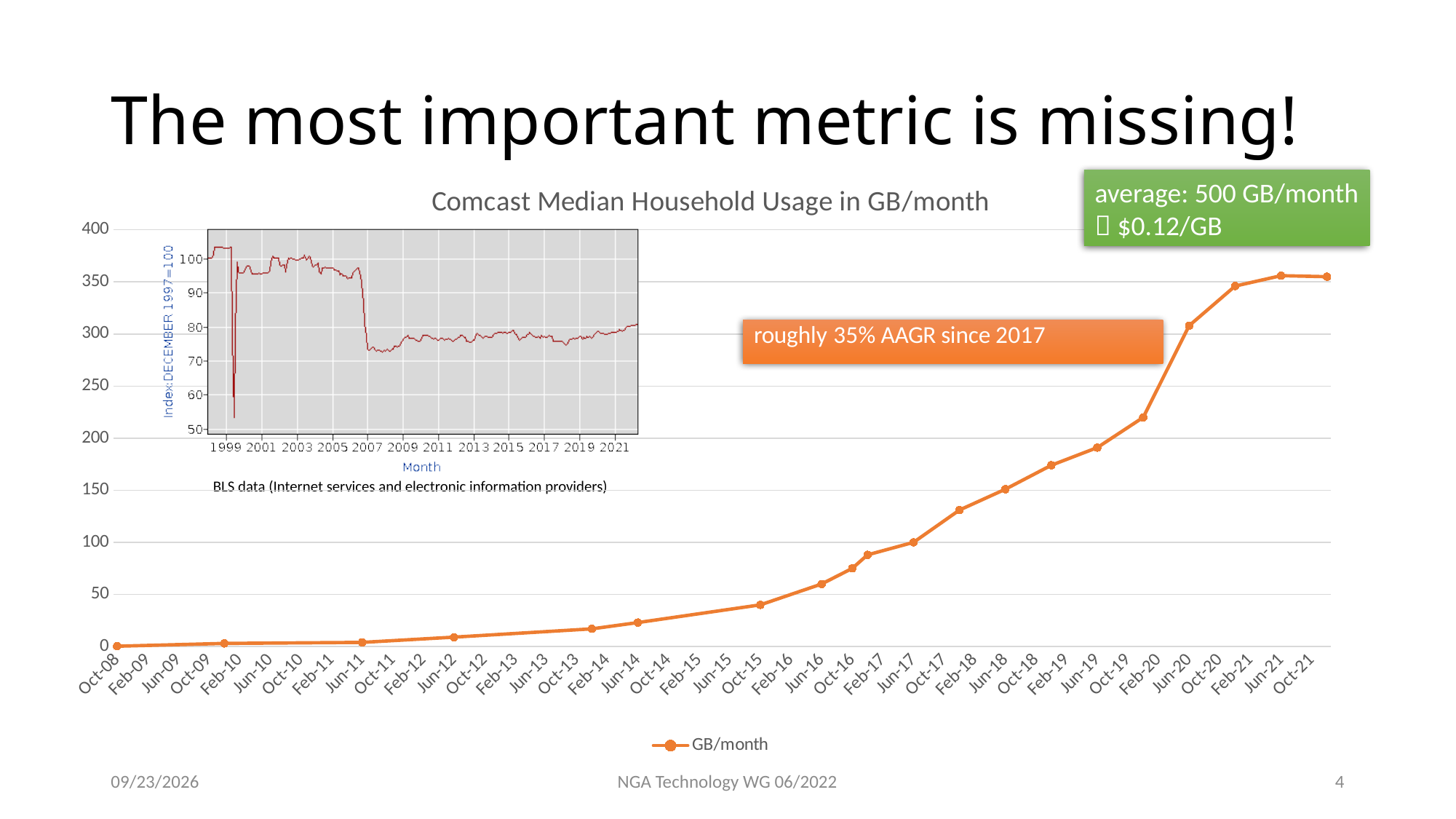
How many series does the legend of the Comcast Median Household Usage chart list? 1 In the Comcast Median Household Usage chart, is the value for Jun-19 greater or less than 200? less In the Comcast Median Household Usage chart, which is larger, the value for Feb-20 or the value for Jun-20? Jun-20 What is the legend entry of the Comcast Median Household Usage chart? GB/month In the Comcast Median Household Usage chart, which is larger, the value for Oct-16 or the value for Feb-18? Feb-18 In the Comcast Median Household Usage chart, do the values generally rise or fall from Oct-08 to Oct-21? rise What is the title of the main chart on the slide? Comcast Median Household Usage in GB/month In the Comcast Median Household Usage chart, which point has the lowest value? Oct-08 In the Comcast Median Household Usage chart, is the value for Oct-15 greater or less than 50? less What kind of chart is the Comcast Median Household Usage chart? line chart In the Comcast Median Household Usage chart, is the value for Jun-20 greater or less than 300? greater